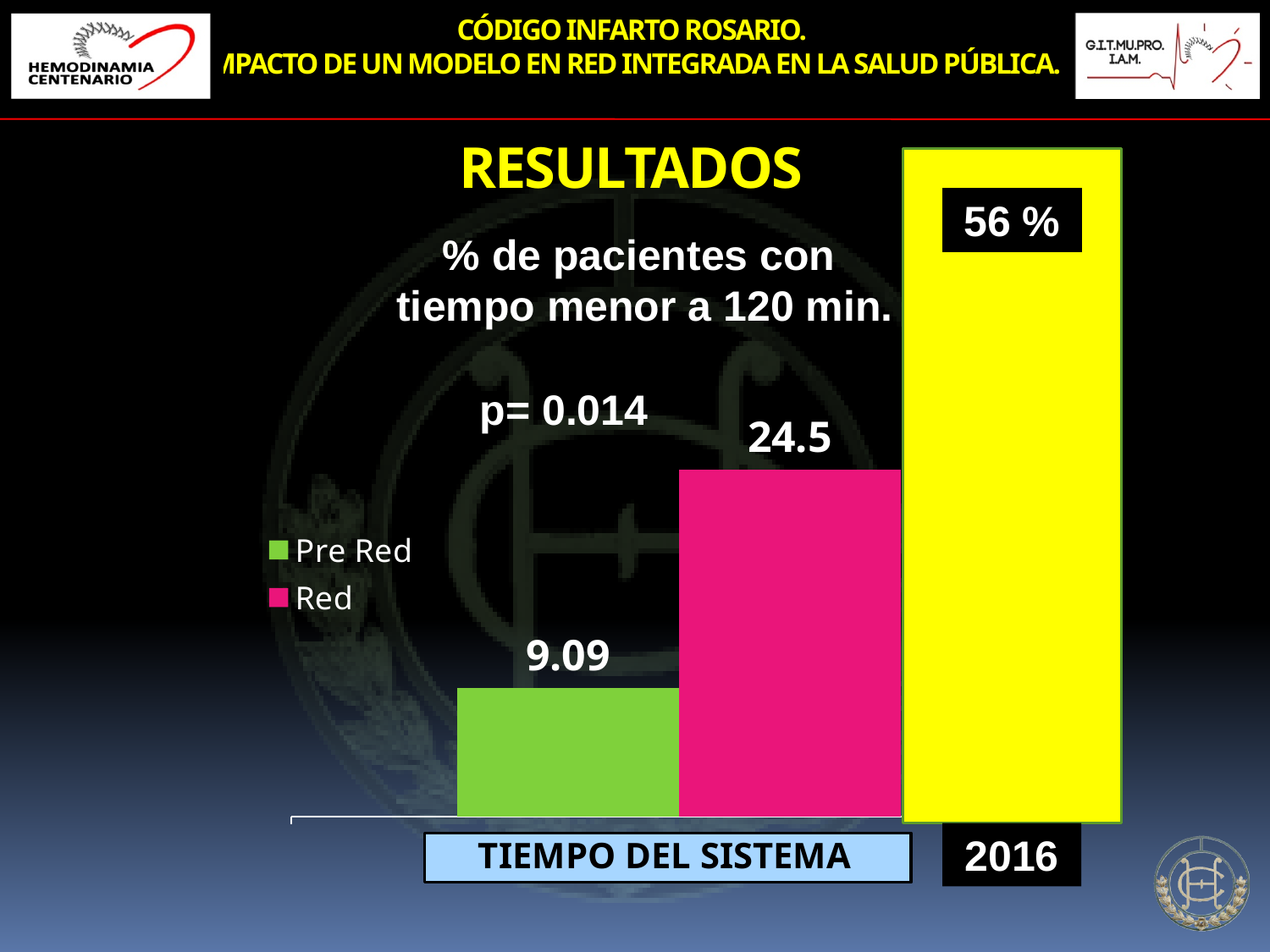
What is the category label shown below the bars? TIEMPO DEL SISTEMA What kind of chart is shown on the slide? Bar chart What is the value of the Red bar for TIEMPO DEL SISTEMA? 24.5 What p-value is printed on the slide next to the chart? p= 0.014 Which bar is the lowest on the slide: Pre Red, Red, or the 2016 bar? Pre Red What percentage is printed on the yellow bar labelled 2016? 56 % How many series does the legend list? 2 What colour is the Red bar? Pink What colour is the Pre Red bar? Green What is the value of the Pre Red bar for TIEMPO DEL SISTEMA? 9.09 What is the difference between the Red value and the Pre Red value for TIEMPO DEL SISTEMA? 15.41 Which series has the higher value for TIEMPO DEL SISTEMA, Pre Red or Red? Red